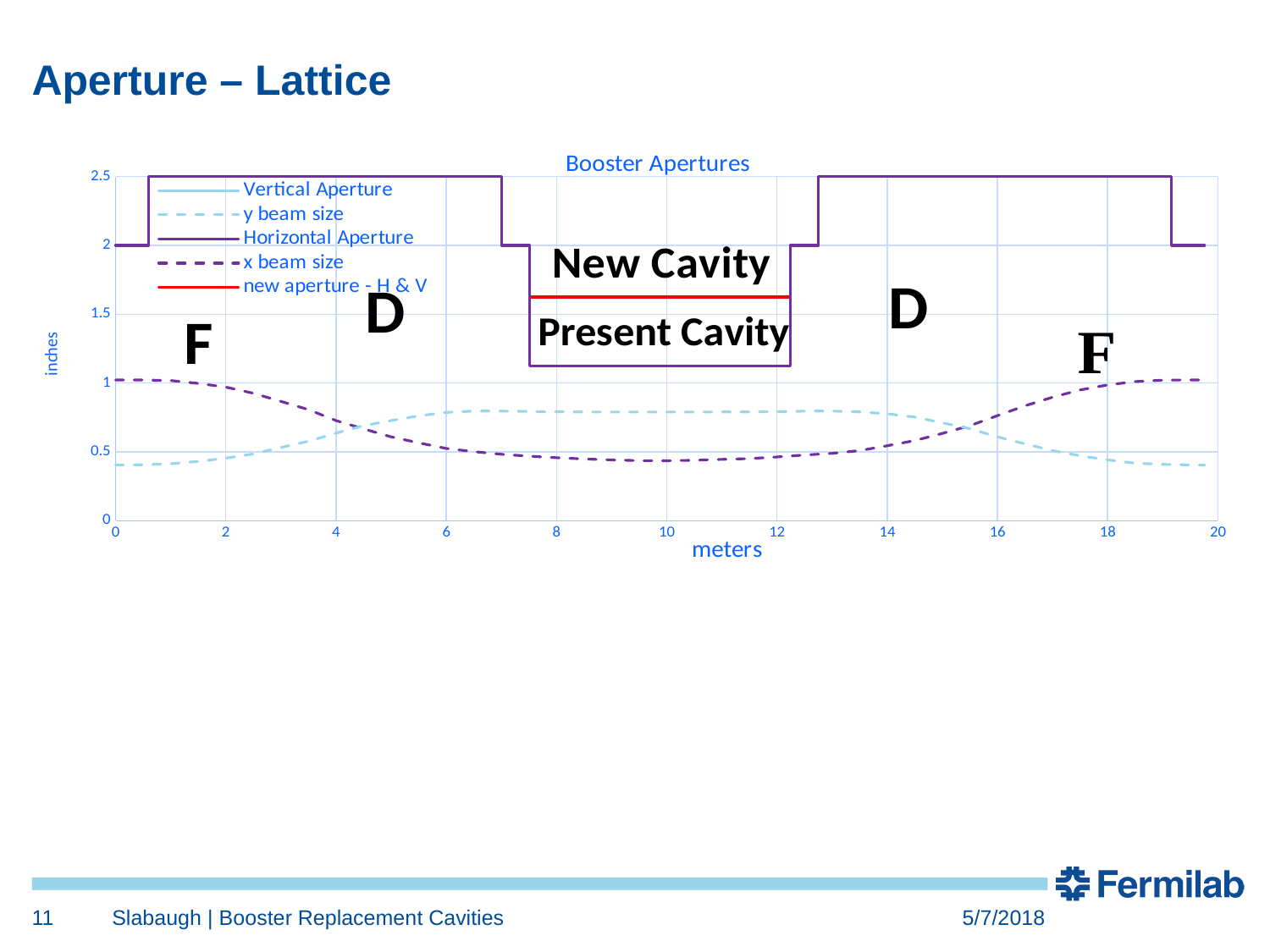
Is the x beam size at 0 meters greater or less than 0.5 inches? greater What is the label of the x axis? meters How many series does the chart legend list? 5 What is the title of the chart? Booster Apertures Is the y beam size at 0 meters greater or less than 0.5 inches? less Does the x beam size rise or fall between 0 and 10 meters? fall What is the value of the Horizontal Aperture at 4 meters? 2.5 Is the Horizontal Aperture at 10 meters greater or less than 2.5 inches? less At 10 meters, which is larger: the x beam size or the y beam size? y beam size Does the y beam size rise or fall between 0 and 8 meters? rise What kind of chart is shown on the slide? line chart